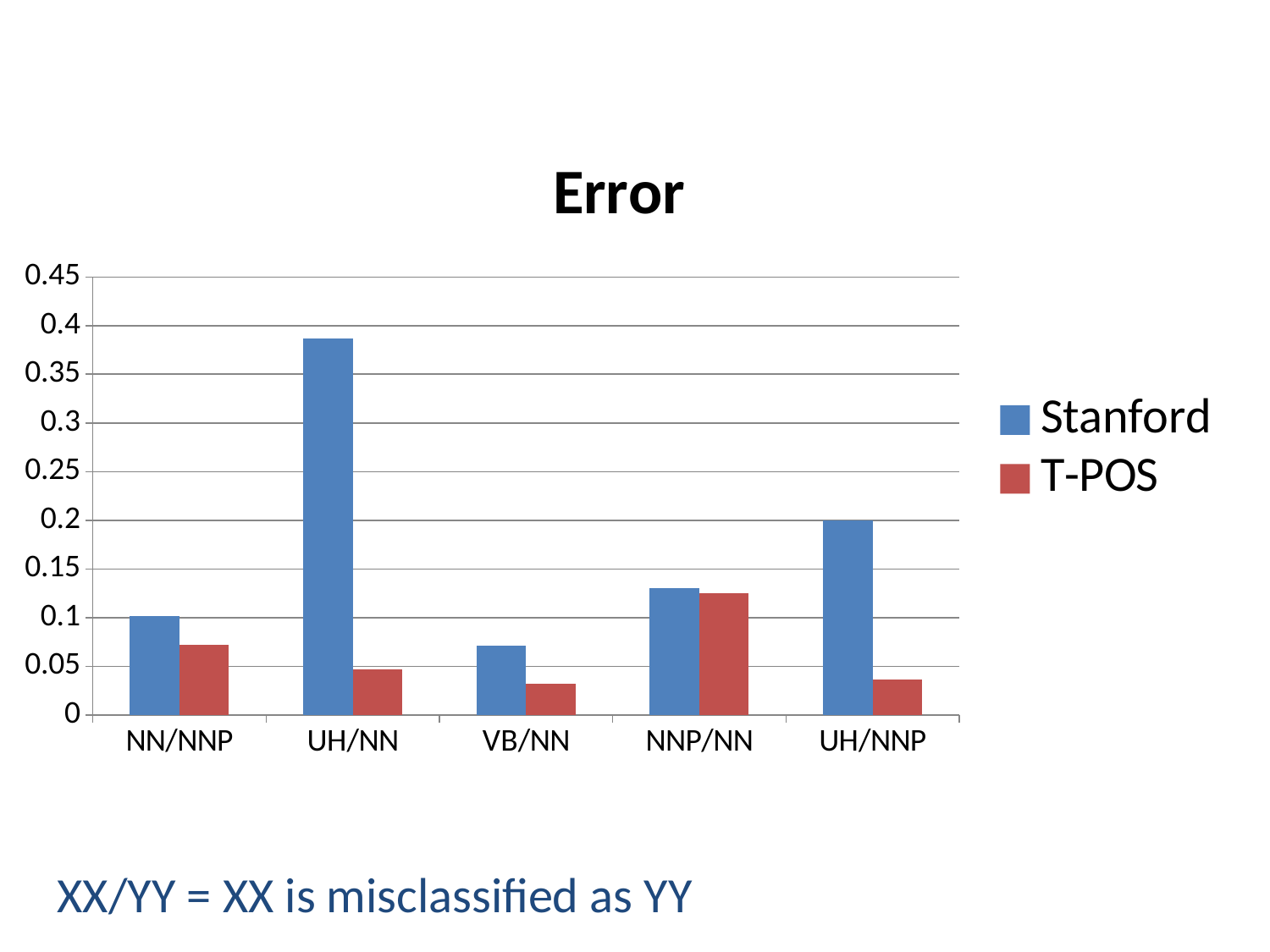
How many series does the legend list? 2 For UH/NN, which series has the larger error, Stanford or T-POS? Stanford Which category has the lowest Stanford error? VB/NN How many categories are shown on the x axis? 5 Which colour represents the T-POS series in the legend? red What kind of chart is shown on the slide? bar chart Which category has the highest T-POS error? NNP/NN Is the Stanford error for UH/NN greater or less than 0.35? greater Is the T-POS error for NN/NNP greater or less than 0.05? greater Is the Stanford error for VB/NN greater or less than 0.1? less What is the title of the chart? Error Which category has the highest Stanford error? UH/NN